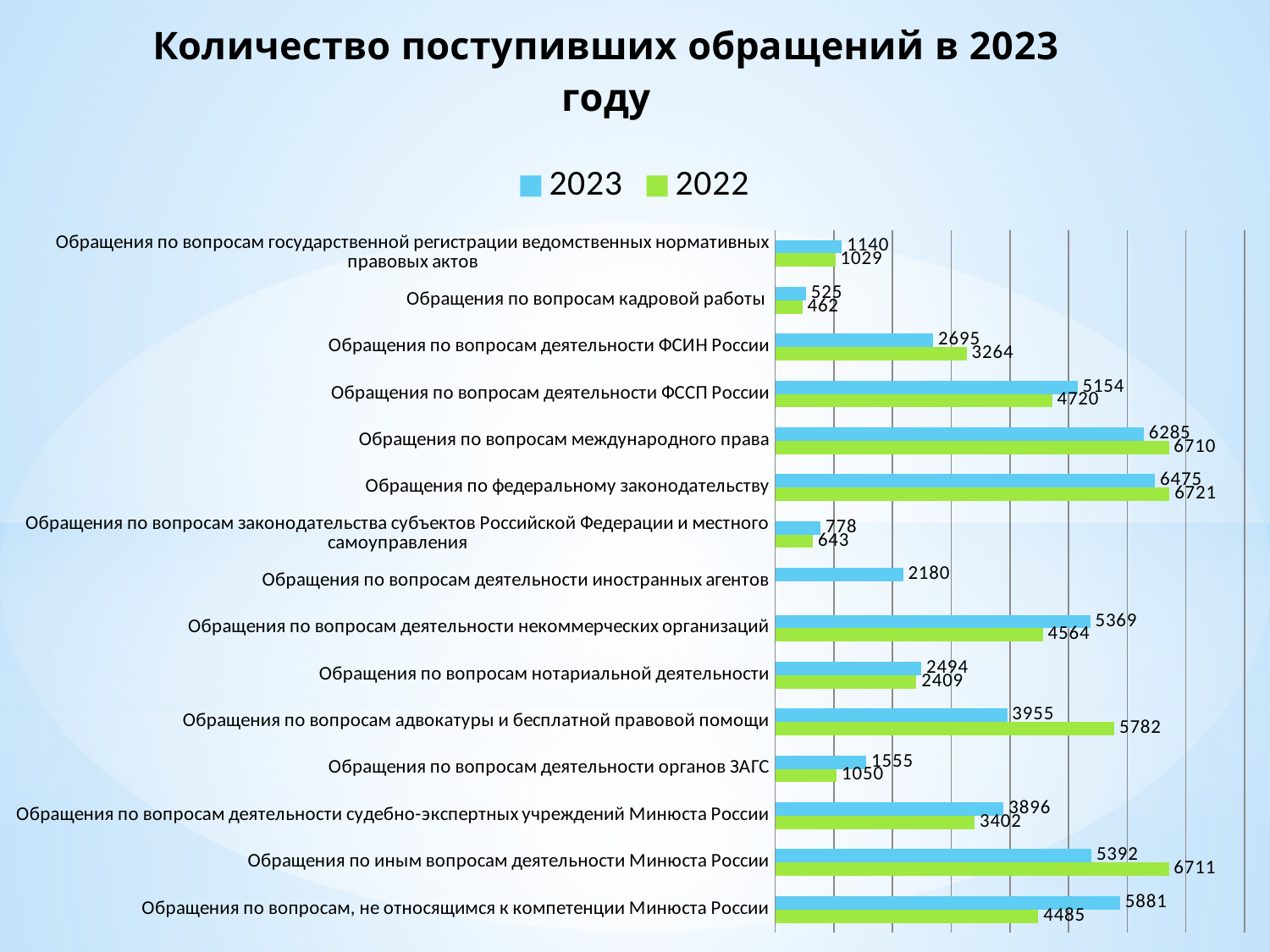
What type of chart is shown on the slide? Bar chart What is the difference between the 2022 and 2023 values for "Обращения по вопросам деятельности органов ЗАГС"? 505 What is the 2023 value for "Обращения по вопросам деятельности ФСИН России"? 2695 What is the 2023 value for "Обращения по вопросам деятельности иностранных агентов"? 2180 What is the 2022 value for "Обращения по вопросам адвокатуры и бесплатной правовой помощи"? 5782 Which category has the lowest 2022 value? Обращения по вопросам кадровой работы For "Обращения по иным вопросам деятельности Минюста России", which year has the larger value, 2023 or 2022? 2022 How many series does the legend list? 2 For "Обращения по вопросам, не относящимся к компетенции Минюста России", which year has the larger value, 2023 or 2022? 2023 How many categories are shown on the chart? 15 Which colour represents the 2022 series in the chart? Green Which category has the highest 2023 value? Обращения по федеральному законодательству